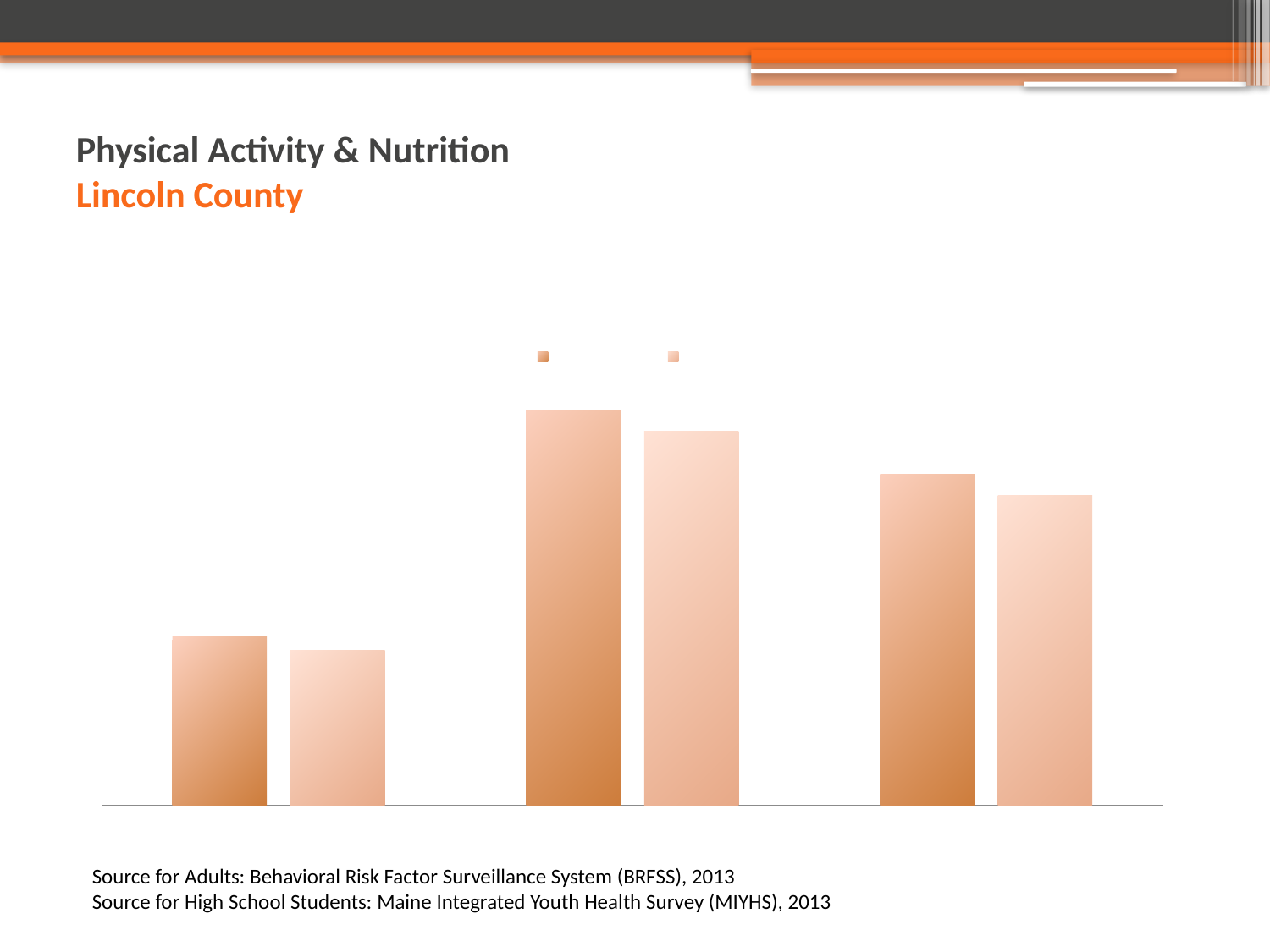
Which group of bars (left, middle or right) has the shortest bars? left Within each group, is the darker orange bar taller or shorter than the lighter bar? taller How many groups of bars does the chart show? 3 What colour are the bars of the first series in the legend? darker orange Is the darker bar in the middle group taller or shorter than the darker bar in the right group? taller How many series does the chart's legend list? 2 What is the title text shown above the chart on the slide? Physical Activity & Nutrition Lincoln County How many bars are plotted in total on the chart? 6 What kind of chart is shown on the slide? bar chart Which group of bars (left, middle or right) has the tallest bars? middle